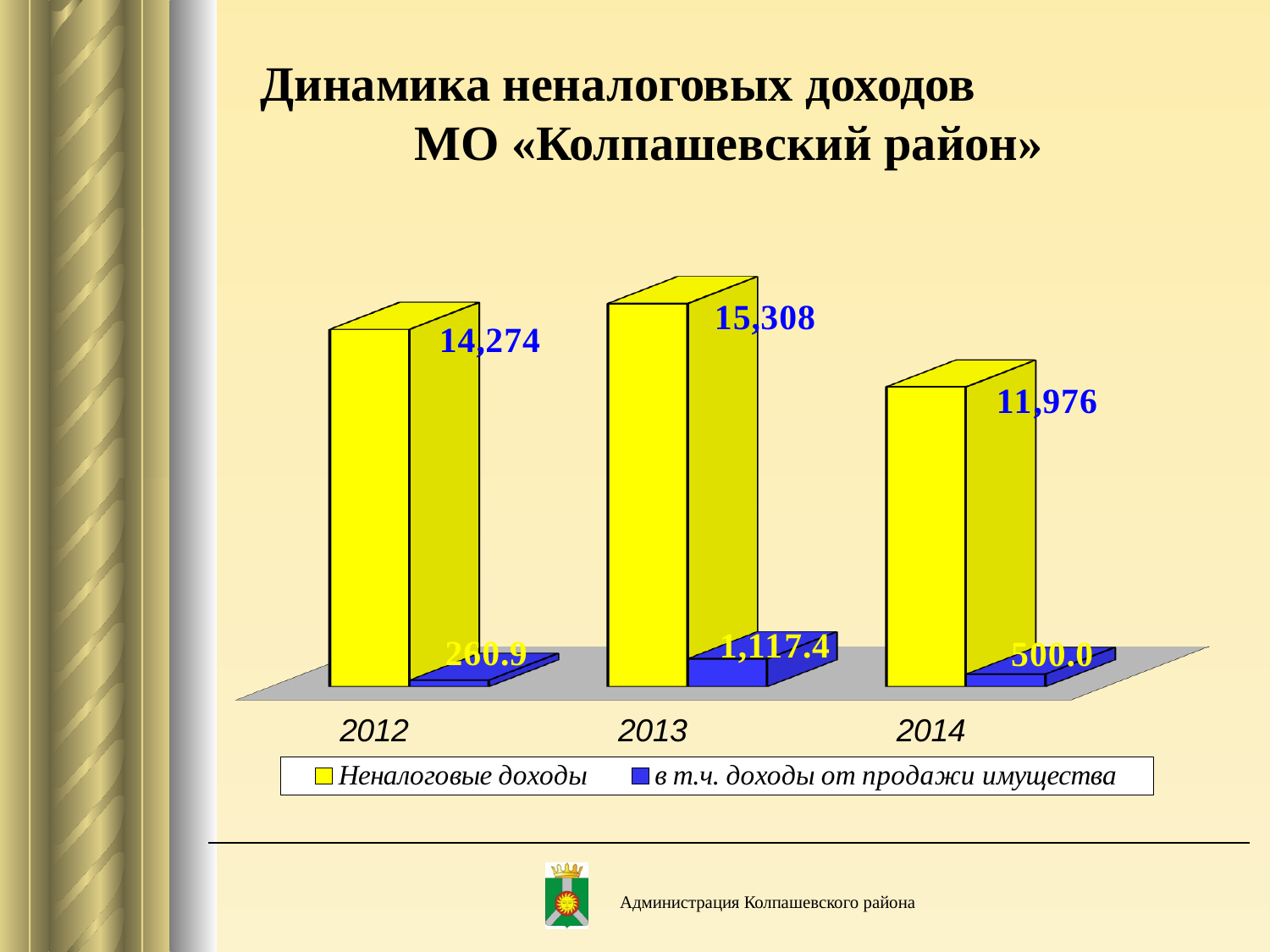
What is the value of в т.ч. доходы от продажи имущества for 2013? 1,117.4 Which is larger: в т.ч. доходы от продажи имущества in 2013 or in 2014? 2013 What is the value of Неналоговые доходы for 2014? 11,976 What is the difference between Неналоговые доходы in 2013 and 2012? 1,034 What is the value of Неналоговые доходы for 2013? 15,308 What is the value of в т.ч. доходы от продажи имущества for 2012? 260.9 How many years are shown on the x axis? 3 How many series does the legend list? 2 In which year is Неналоговые доходы highest? 2013 In which year is в т.ч. доходы от продажи имущества lowest? 2012 What is the difference between Неналоговые доходы in 2013 and 2014? 3,332 In which year is Неналоговые доходы lowest? 2014